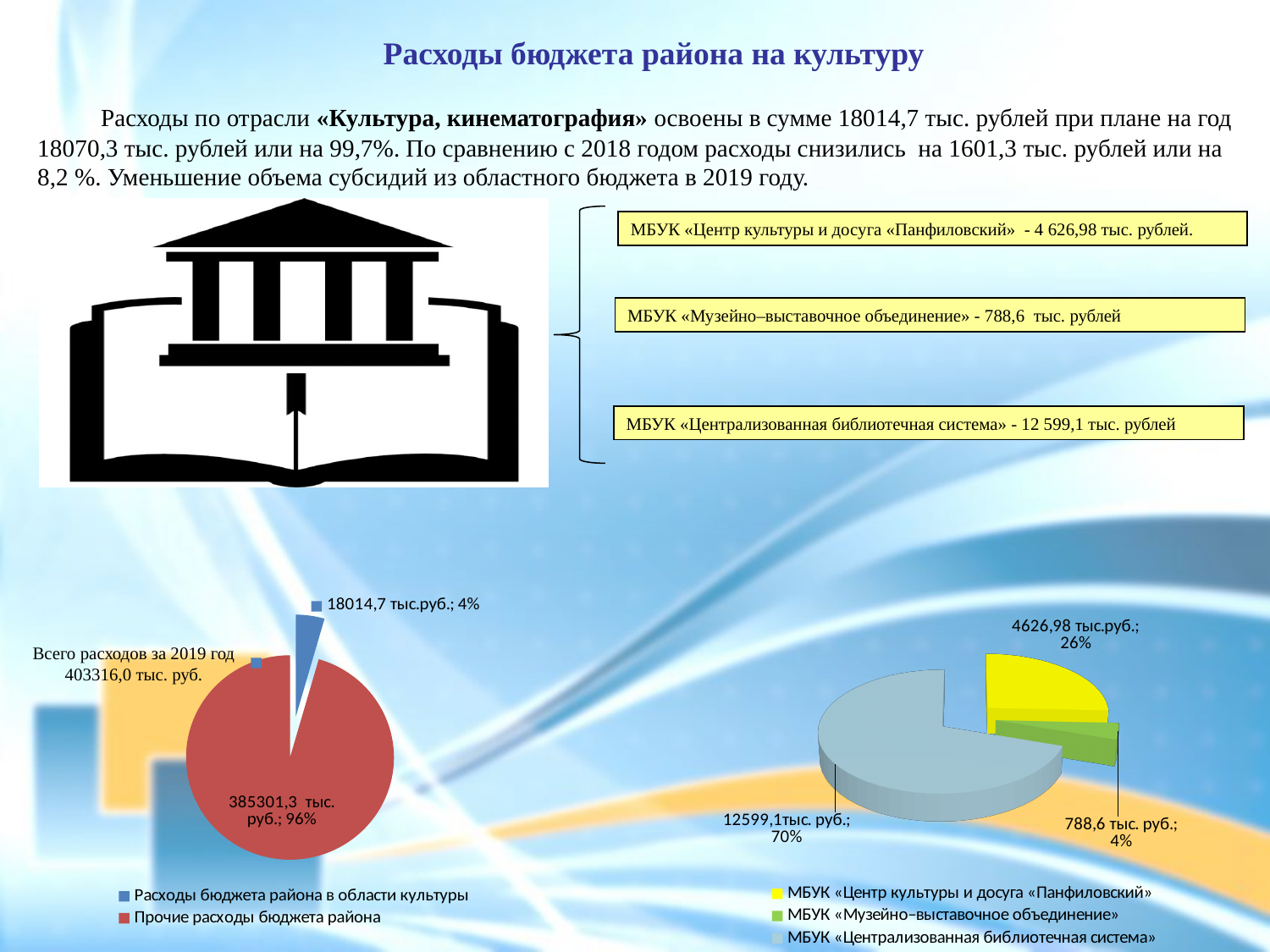
What kind of chart is the chart on the left of the slide? Pie chart On the right pie chart, which category has the smallest slice? МБУК «Музейно–выставочное объединение» On the right pie chart, how many entries does the legend list? 3 On the right pie chart, what value is shown for МБУК «Музейно–выставочное объединение»? 788,6 тыс. руб.; 4% On the left pie chart, what share of the pie is «Прочие расходы бюджета района»? 96% On the right pie chart, what share of the pie is МБУК «Центр культуры и досуга «Панфиловский»? 26% On the left pie chart, how many slices are there? 2 On the right pie chart, what value is shown for МБУК «Централизованная библиотечная система»? 12599,1 тыс. руб.; 70% On the right pie chart, which colour represents МБУК «Центр культуры и досуга «Панфиловский»? Yellow On the left pie chart, what value is shown for «Прочие расходы бюджета района»? 385301,3 тыс. руб.; 96% On the right pie chart, which category has the largest slice? МБУК «Централизованная библиотечная система» On the left pie chart, what value is shown for «Расходы бюджета района в области культуры»? 18014,7 тыс.руб.; 4%